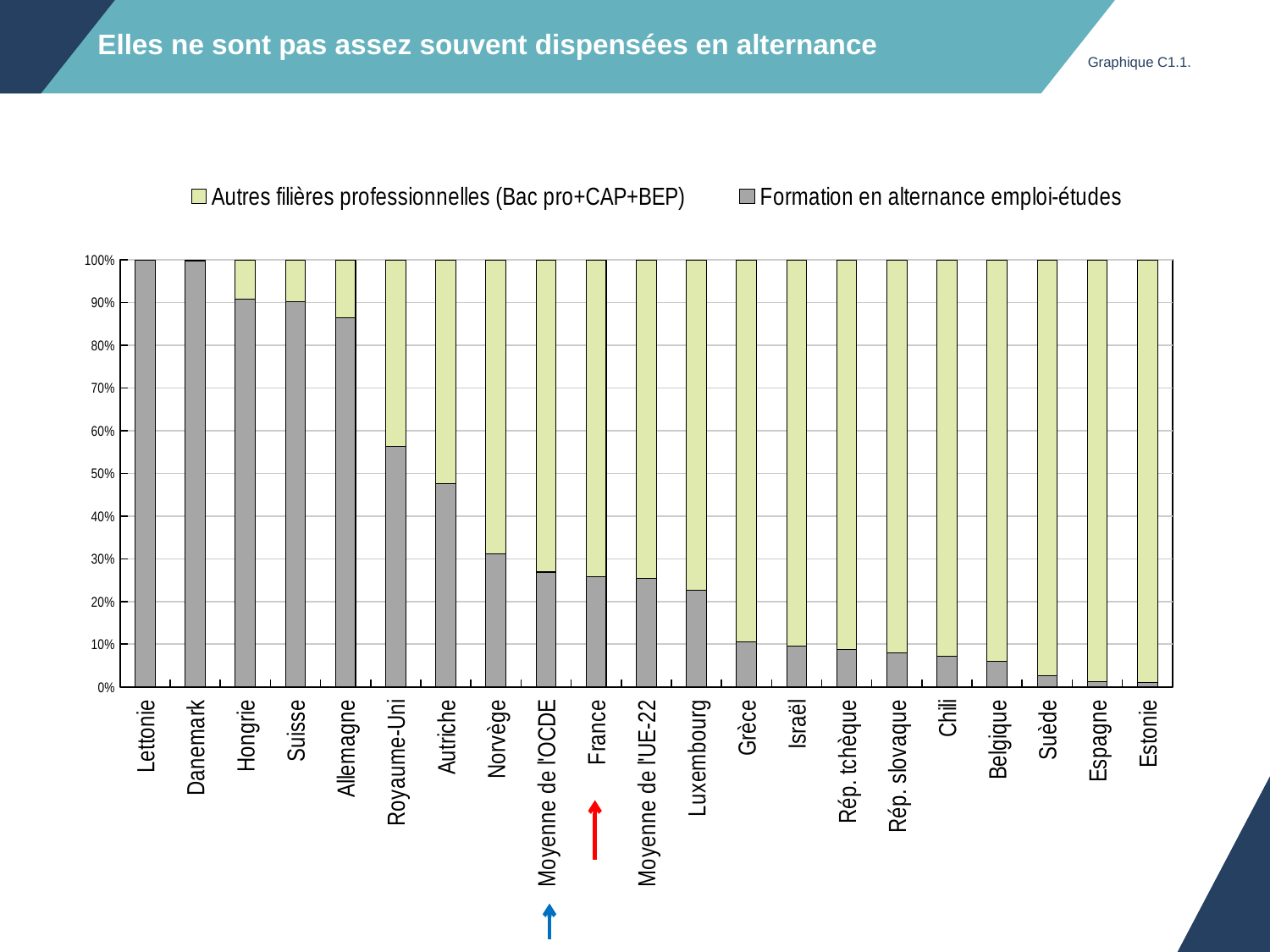
Is the value of 'Formation en alternance emploi-études' for Royaume-Uni greater or less than 50%? greater Does the share of 'Formation en alternance emploi-études' rise or fall from left to right along the x axis? Fall What kind of chart is shown on the slide? Stacked bar chart What is the value of 'Formation en alternance emploi-études' for Lettonie? 100% Is the value of 'Formation en alternance emploi-études' for Norvège greater or less than 40%? less What is the name of the second legend entry? Formation en alternance emploi-études How many series does the legend list? 2 Is the value of 'Formation en alternance emploi-études' for Grèce greater or less than 20%? less What is the total height of the stacked bar for France? 100% How many categories are shown on the x axis of the chart? 21 Which has a larger share of 'Formation en alternance emploi-études', Royaume-Uni or Autriche? Royaume-Uni